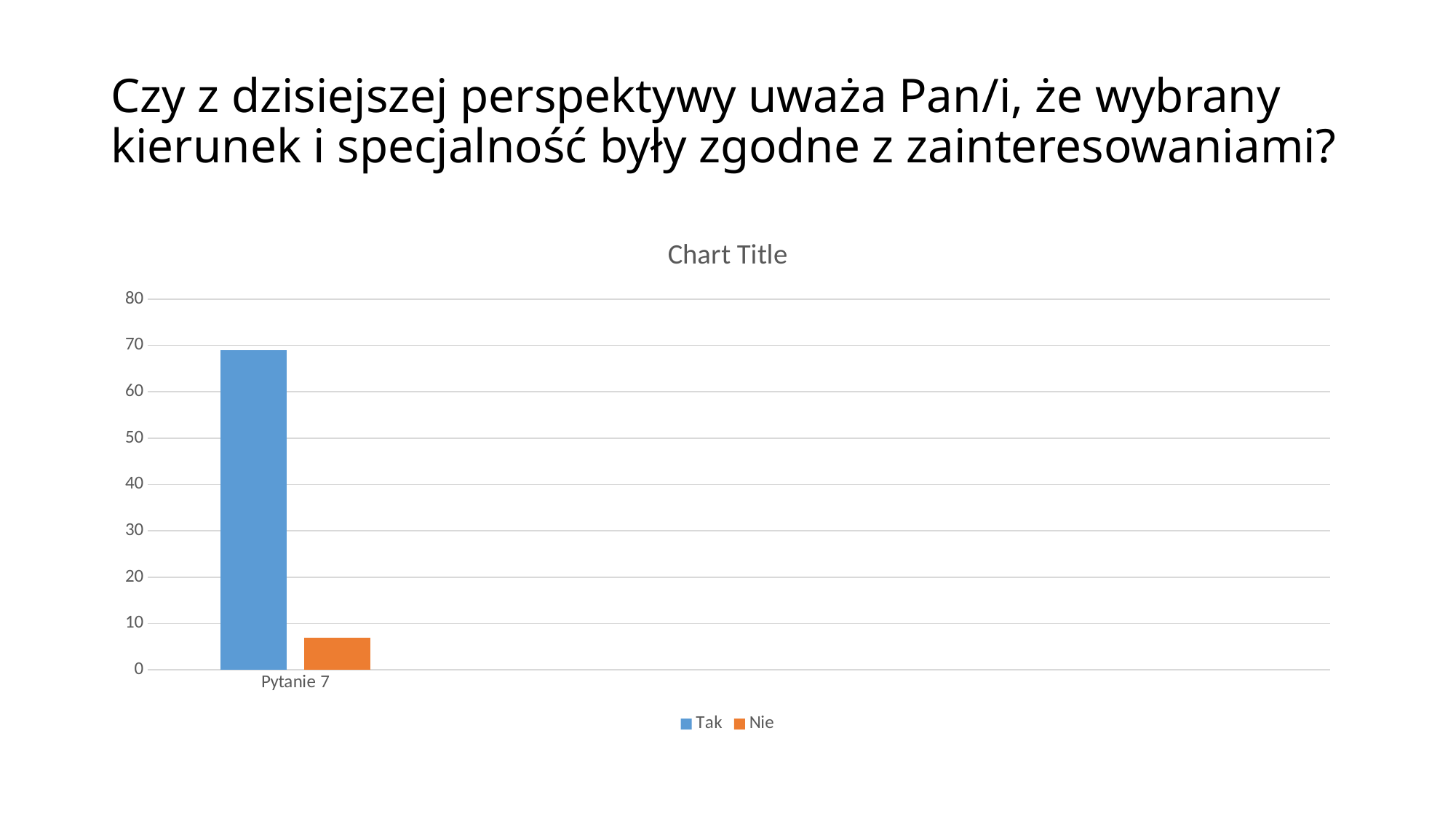
How many series does the legend list? 2 Which series has the lowest value in the chart? Nie What kind of chart is shown on the slide? bar chart Which series has the higher value for Pytanie 7, Tak or Nie? Tak What colour is the bar for the Nie series? orange Is the value for Tak greater or less than 60? greater Is the value for Nie greater or less than 10? less How many categories are shown on the x axis? 1 What is the label of the category on the x axis? Pytanie 7 Which series has the highest value in the chart? Tak